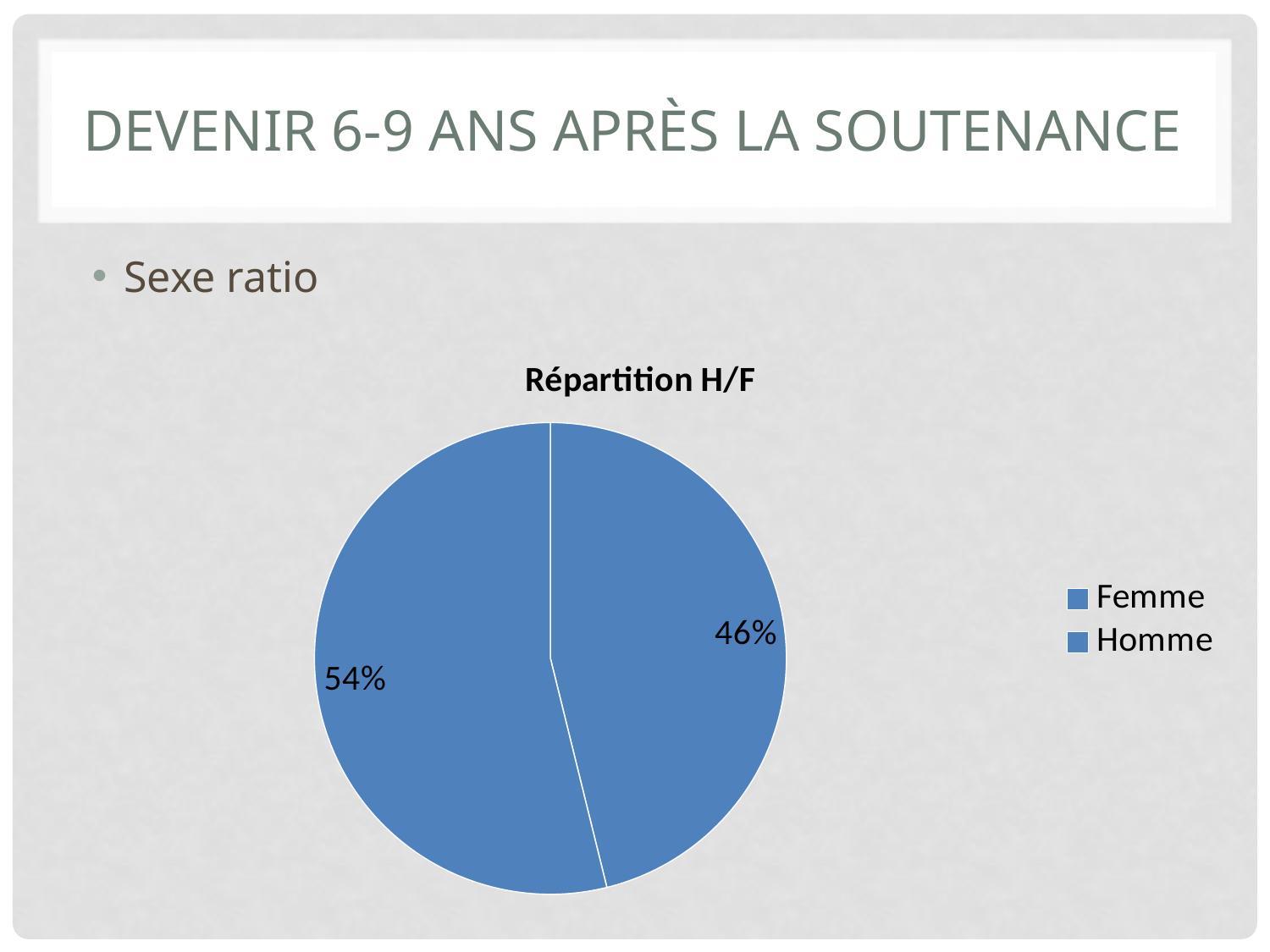
How many slices does the pie chart have? 2 Is the left-hand slice (54%) larger or smaller than the right-hand slice (46%)? larger Is the share of the right-hand slice greater or less than 50%? less What is the share of the smallest slice in the pie chart? 46% What is the title of the chart? Répartition H/F What kind of chart is shown on the slide? pie chart What is the share of the largest slice in the pie chart? 54% What percentage is printed on the right-hand slice of the pie? 46% How many entries does the legend list? 2 What are the two entries listed in the legend? Femme and Homme What percentage is printed on the left-hand slice of the pie? 54% What is the difference in percentage points between the two slices? 8